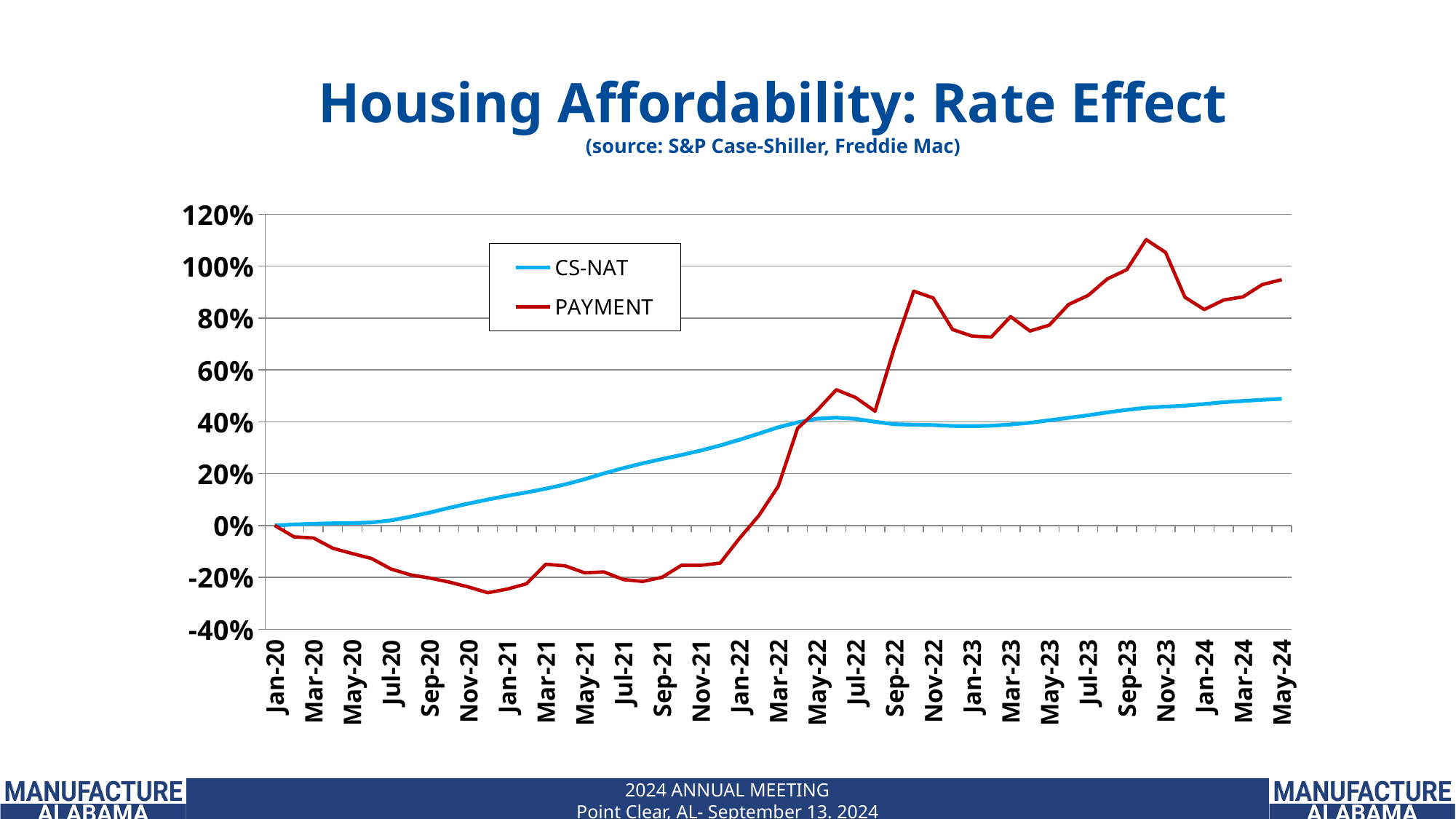
Is the CS-NAT value at Jan-22 greater or less than 20%? greater What are the two series named in the legend? CS-NAT and PAYMENT At Jan-21, which series has the higher value, CS-NAT or PAYMENT? CS-NAT What kind of chart is shown on the slide? Line chart At May-24, which series has the higher value, CS-NAT or PAYMENT? PAYMENT What is the title of the chart? Housing Affordability: Rate Effect Is the PAYMENT value at Mar-22 greater or less than 40%? less Which series reaches the highest value anywhere on the chart? PAYMENT Is the PAYMENT value at Nov-20 greater or less than -20%? less How many series does the legend list? 2